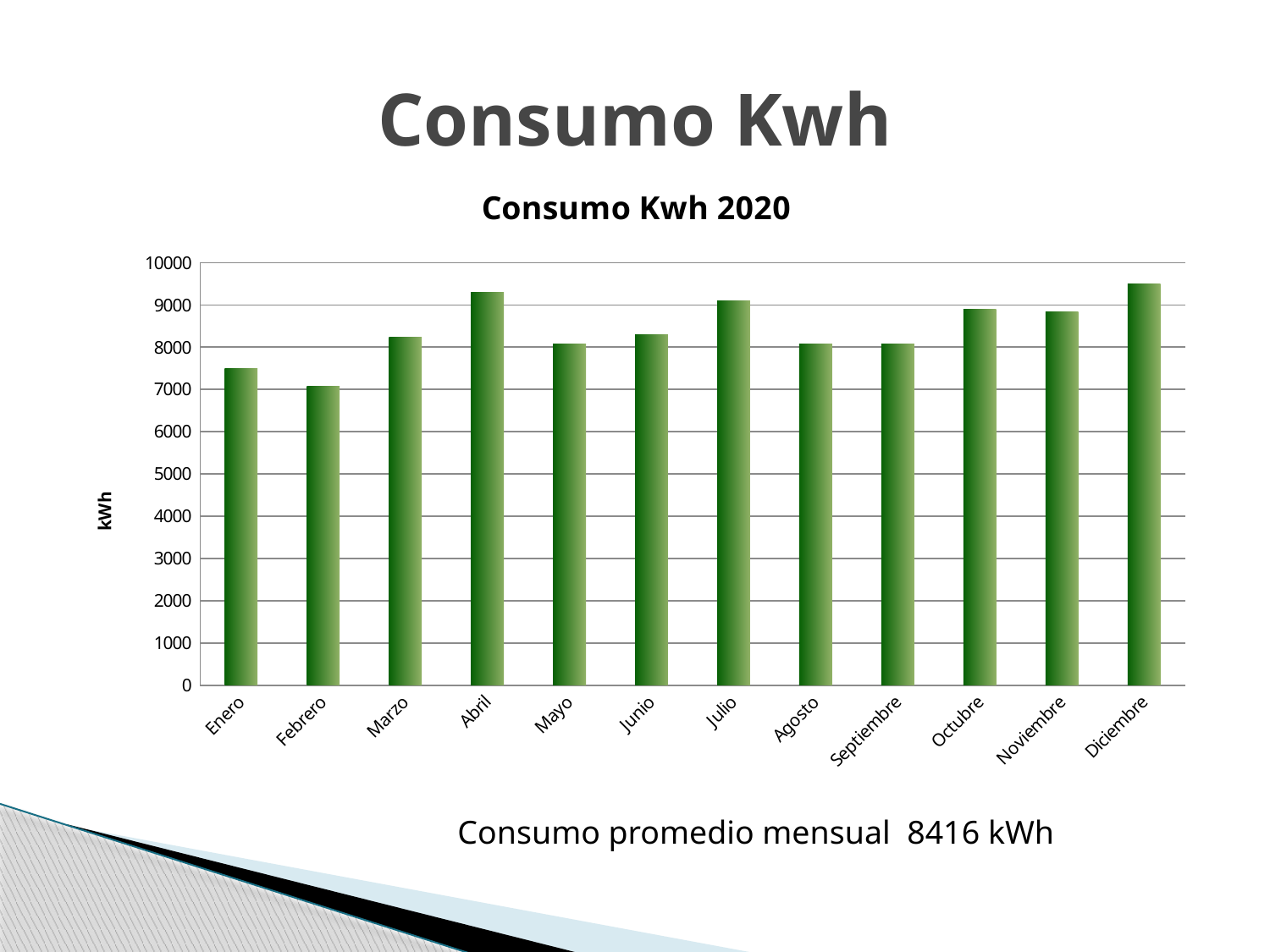
Which is larger, the value for Abril or the value for Enero? Abril What is the title of the chart? Consumo Kwh 2020 Is the value for Junio greater or less than 8000? greater Which month has the highest consumption in the chart? Diciembre What label is shown on the vertical axis of the chart? kWh Is the value for Febrero greater or less than 8000? less What kind of chart is shown on the slide? Bar chart How many months (categories) are plotted on the chart? 12 Is the value for Abril greater or less than 9000? greater Which month has the lowest consumption in the chart? Febrero Which is larger, the value for Marzo or the value for Febrero? Marzo